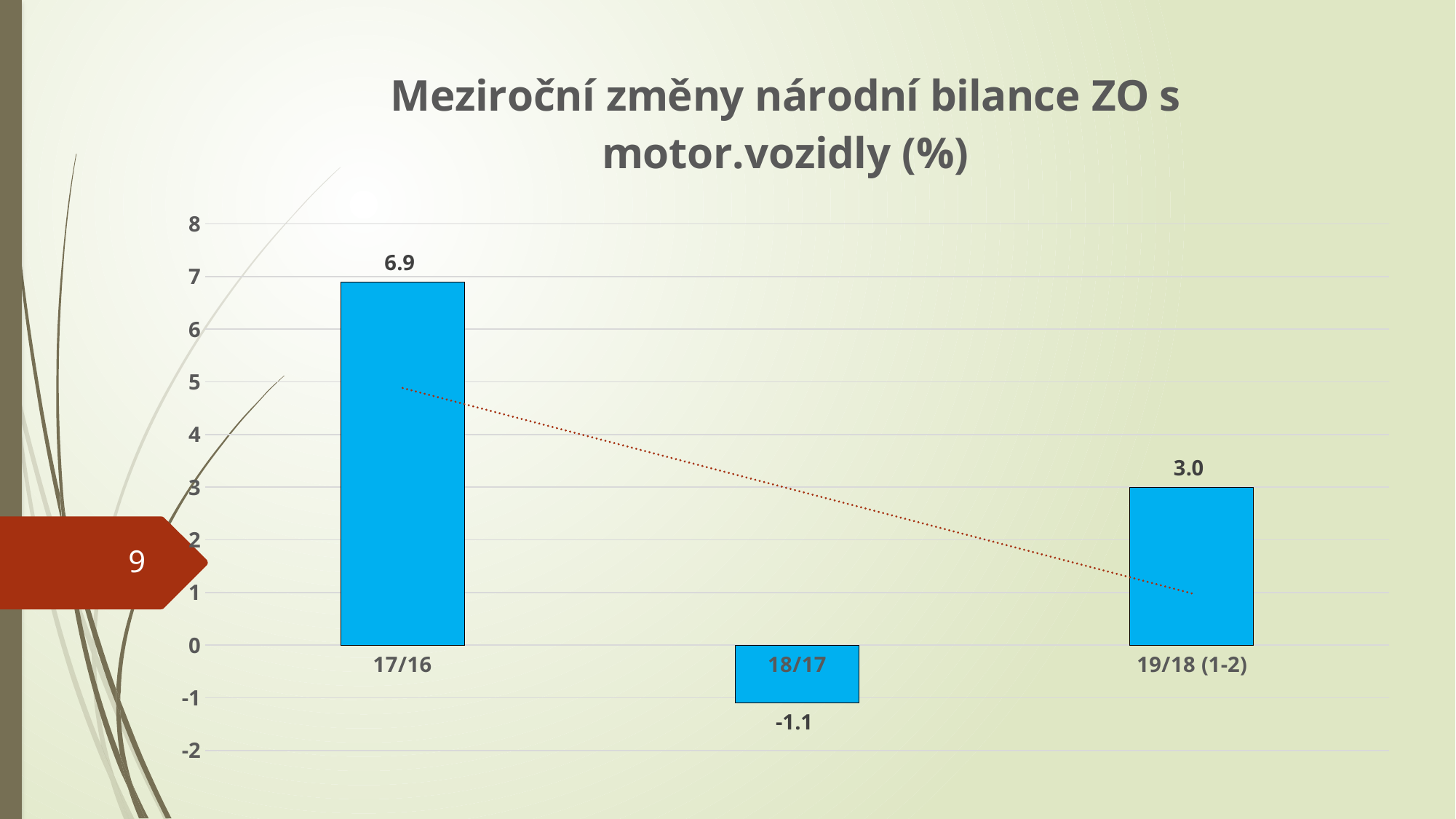
What is the value for 19/18 (1-2)? 3.0 Which is larger, the value for 17/16 or the value for 19/18 (1-2)? 17/16 What is the difference between the values for 17/16 and 19/18 (1-2)? 3.9 What is the value for 18/17? -1.1 What kind of chart is shown on the slide? bar chart What is the value for 17/16? 6.9 How many categories are shown on the x axis? 3 Is the value for 17/16 greater or less than 5? greater Which category has the highest value? 17/16 What is the difference between the values for 19/18 (1-2) and 18/17? 4.1 What is the title of the chart? Meziroční změny národní bilance ZO s motor.vozidly (%) Which category has the lowest value? 18/17